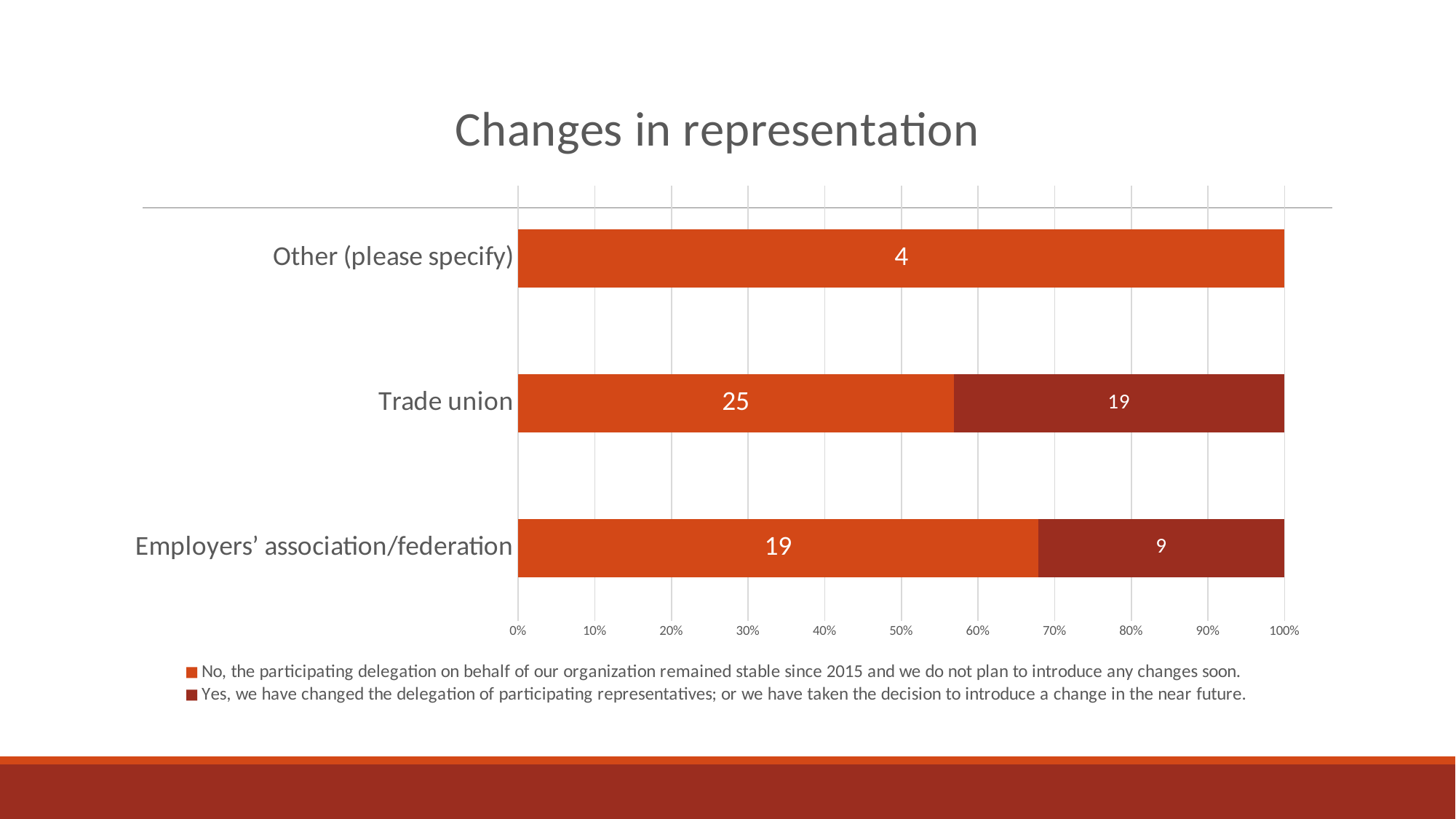
Which is larger: the 'Yes' value for Trade union or the 'Yes' value for Employers' association/federation? Trade union What kind of chart is shown on the slide? Stacked bar chart How many categories are shown on the chart? 3 Which category has the highest value in the 'No, the participating delegation ... remained stable' series? Trade union What is the value for Employers' association/federation in the 'Yes, we have changed the delegation ...' series? 9 What is the value for Trade union in the 'Yes, we have changed the delegation ...' series? 19 What is the value for Trade union in the 'No, the participating delegation ... remained stable' series? 25 What is the difference between the 'No' value and the 'Yes' value for Trade union? 6 What is the total of the two values in the Trade union bar? 44 Is the share of the 'No' segment for Employers' association/federation greater or less than 60%? greater Which category has the lowest value in the 'No, the participating delegation ... remained stable' series? Other (please specify) What is the value for Other (please specify) in the 'No, the participating delegation ... remained stable' series? 4